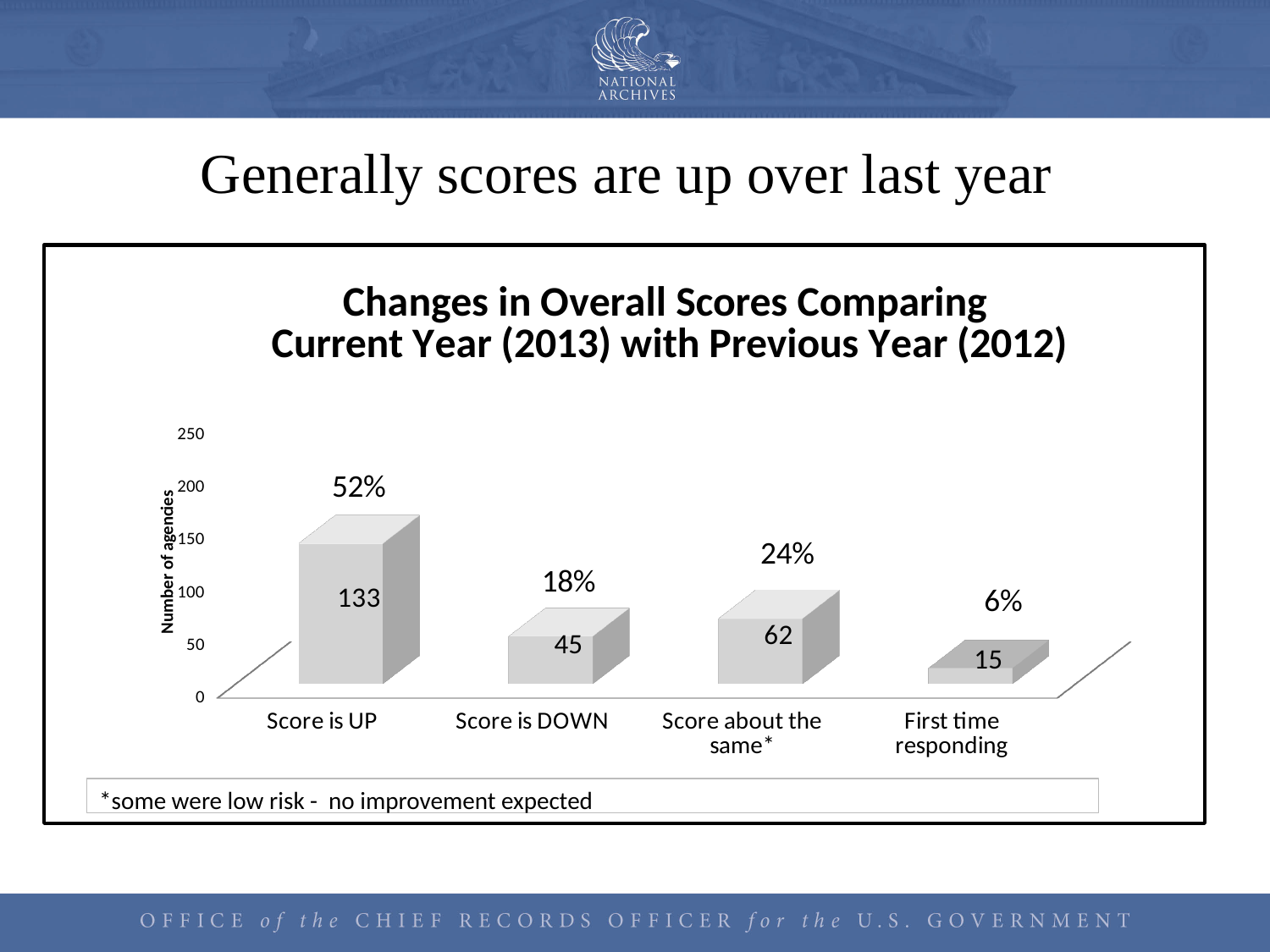
What percentage is shown above the 'Score about the same*' bar? 24% What is the difference in number of agencies between 'Score is UP' and 'Score is DOWN'? 88 Which has more agencies, 'Score about the same*' or 'Score is DOWN'? Score about the same* What kind of chart is shown on the slide? Bar chart What is the number of agencies for 'First time responding'? 15 Which category has the lowest number of agencies? First time responding Which category has the highest number of agencies? Score is UP What is the title of the chart? Changes in Overall Scores Comparing Current Year (2013) with Previous Year (2012) What is the number of agencies for 'Score is UP'? 133 What is the number of agencies for 'Score is DOWN'? 45 How many categories are shown on the x axis? 4 What is the number of agencies for 'Score about the same*'? 62